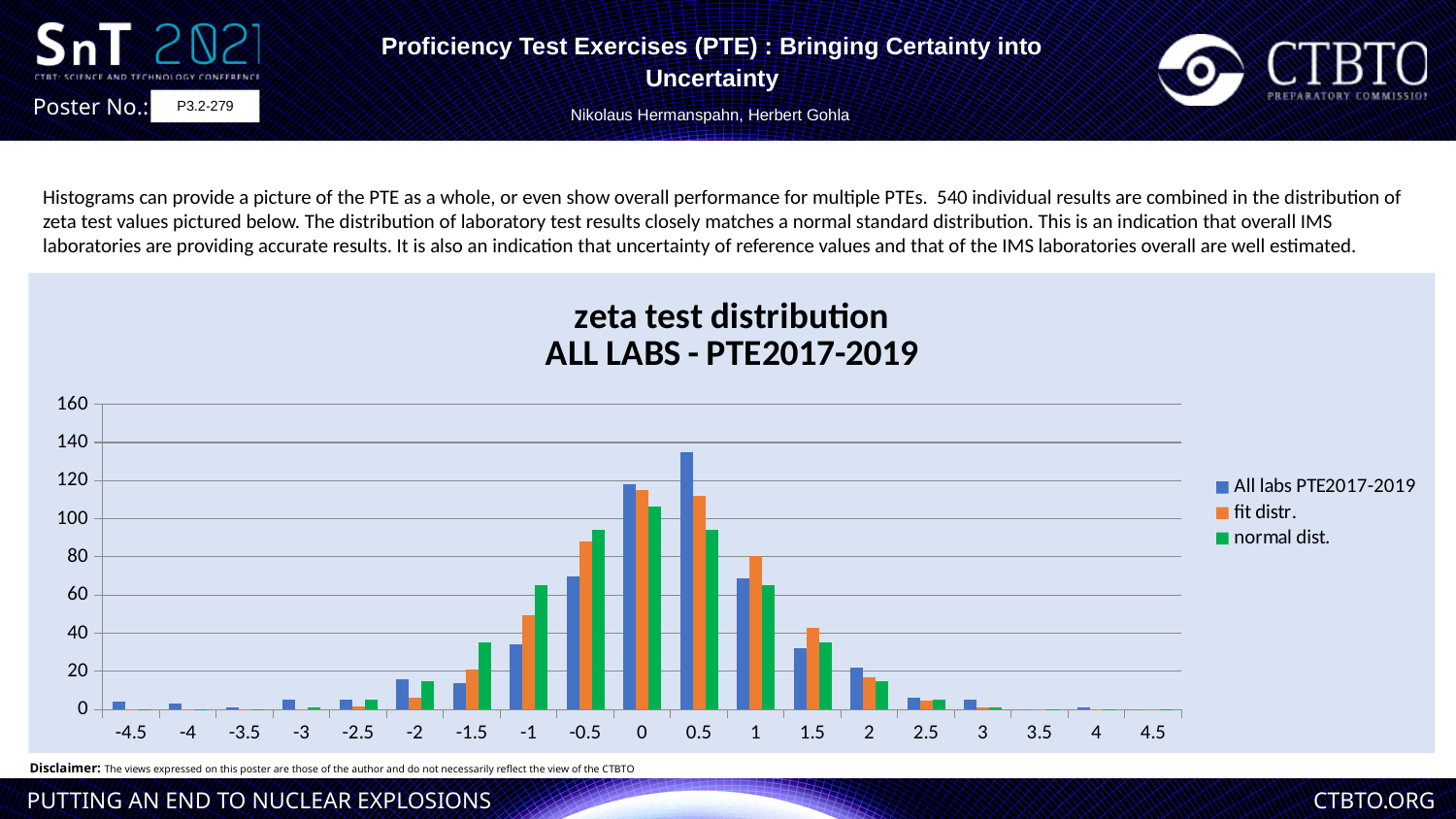
Is the value of All labs PTE2017-2019 at -2 greater or less than 20? less How many categories are shown along the x axis? 19 At category -1, which series has the larger value: All labs PTE2017-2019 or normal dist.? normal dist. How many series does the legend list? 3 At which x-axis category is the All labs PTE2017-2019 bar highest? 0.5 Is the value of normal dist. at -0.5 greater or less than 80? greater At category 0.5, which series has the larger value: All labs PTE2017-2019 or fit distr.? All labs PTE2017-2019 What is the title of the chart? zeta test distribution ALL LABS - PTE2017-2019 Which series is shown in green in the legend? normal dist. Is the value of fit distr. at 0 greater or less than 120? less What kind of chart is shown on the slide? bar chart